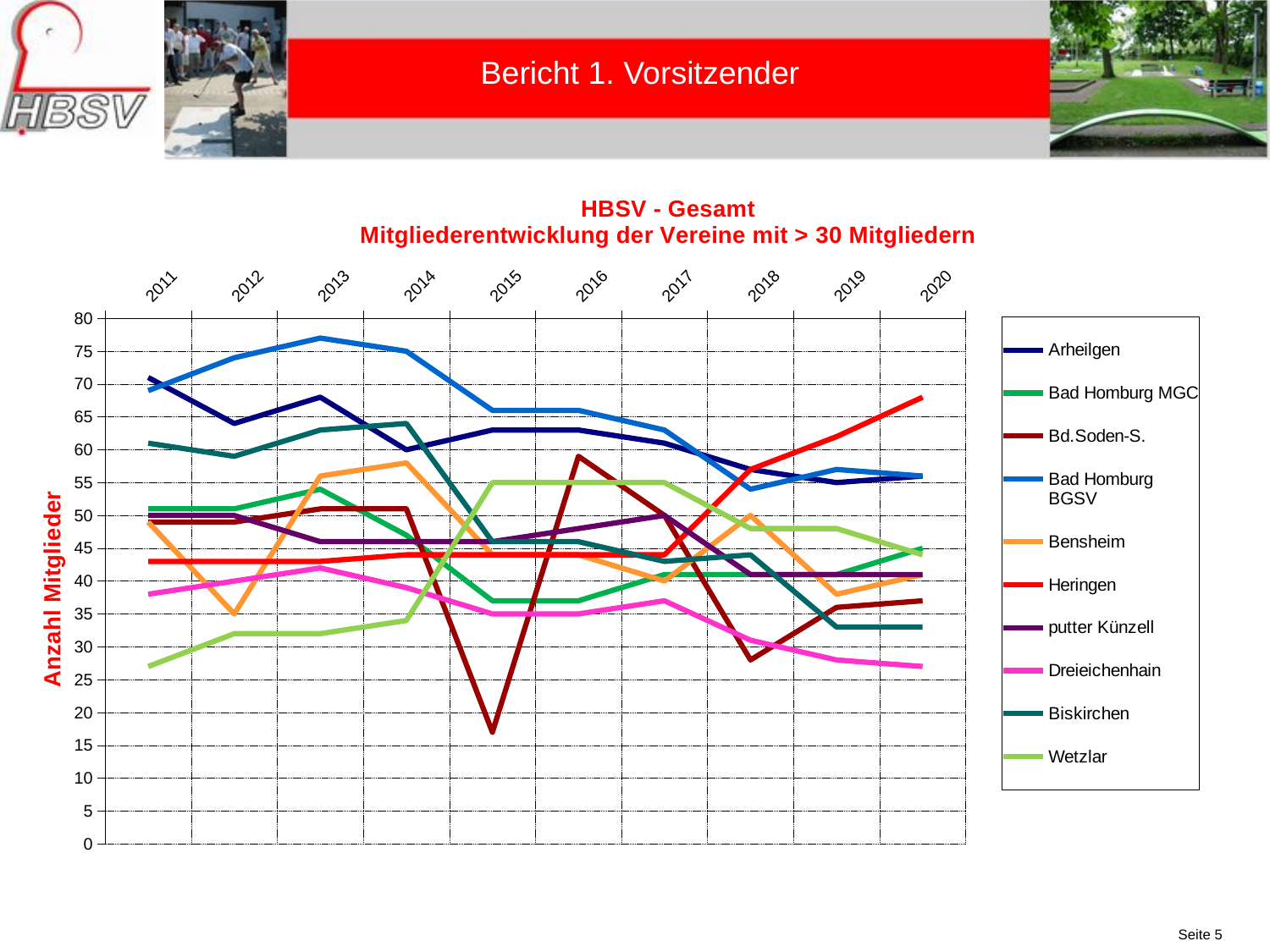
How many years are shown along the x axis? 10 Which series has the lowest value in 2020? Dreieichenhain Is the value for Heringen in 2020 greater or less than 65? greater Is the value for Bd.Soden-S. in 2015 greater or less than 20? less What is the label of the y axis? Anzahl Mitglieder How many series does the legend list? 10 Is the value for Bad Homburg BGSV in 2013 greater or less than 75? greater What kind of chart is shown on the slide? line chart In 2013, which is larger: the value for Bad Homburg BGSV or the value for Arheilgen? Bad Homburg BGSV Does the value for Heringen rise or fall from 2016 to 2020? rise Which series has the highest value in 2020? Heringen